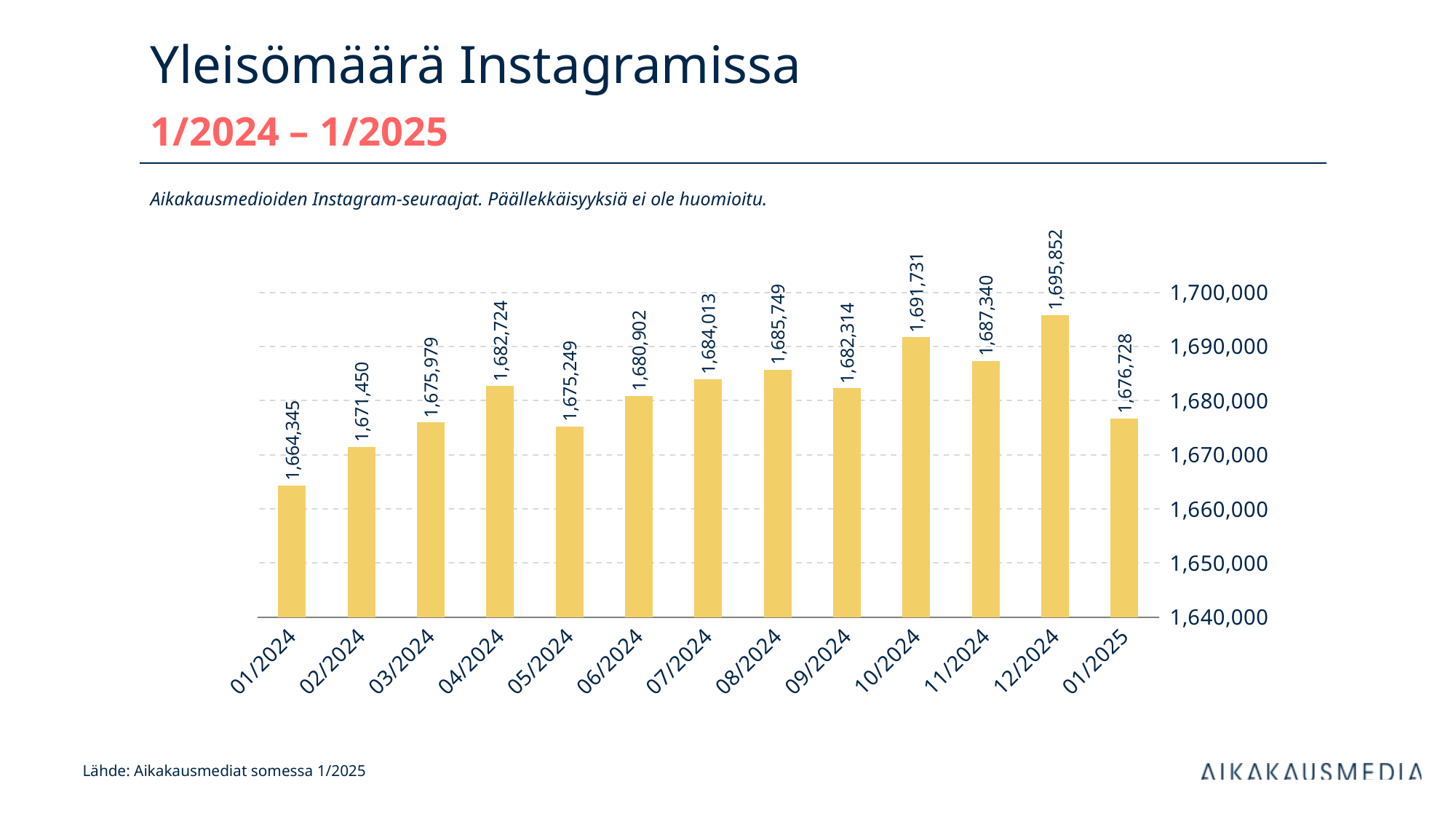
What is the title of the chart on the slide? Yleisömäärä Instagramissa Which month has the highest value? 12/2024 Which is larger, the value for 04/2024 or the value for 05/2024? 04/2024 What kind of chart is shown on the slide? bar chart What is the difference between the values for 12/2024 and 01/2024? 31,507 What is the value for 12/2024? 1,695,852 Is the value for 01/2025 greater or less than 1,680,000? less Which month has the lowest value? 01/2024 What is the value for 07/2024? 1,684,013 How many months are shown on the x axis? 13 What is the value for 01/2024? 1,664,345 What is the difference between the values for 10/2024 and 11/2024? 4,391